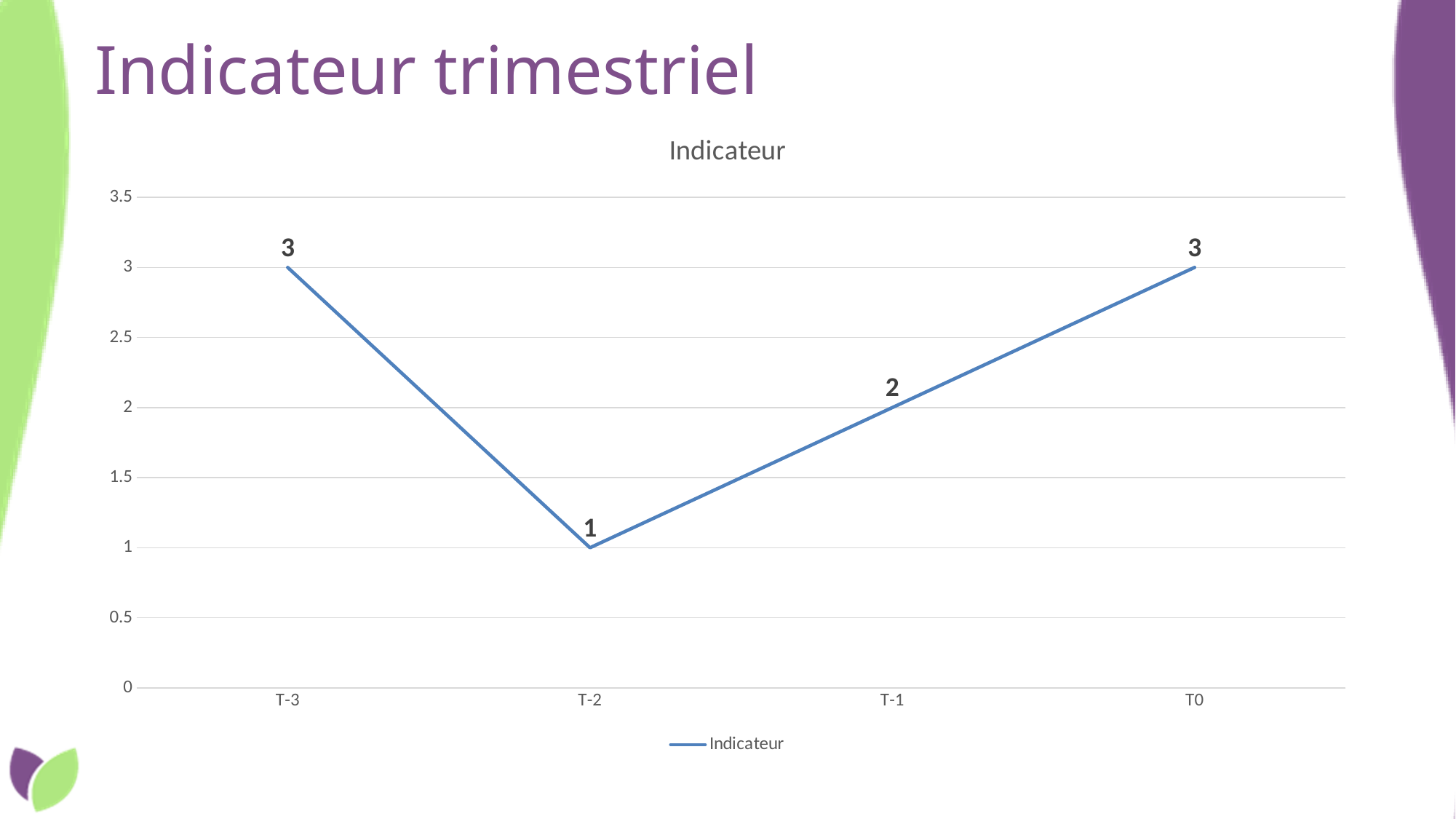
Which is larger, the Indicateur value at T-1 or at T-2? T-1 What is the value of Indicateur at T-2? 1 What is the value of Indicateur at T0? 3 Do the Indicateur values rise or fall from T-2 to T0? rise What is the title of the chart? Indicateur Is the value for T-1 greater or less than 1.5? greater At which point on the x axis is the Indicateur value lowest? T-2 How many points are plotted on the x axis? 4 What is the difference between the Indicateur values at T-3 and T-2? 2 How many series does the legend list? 1 What kind of chart is shown on the slide? line chart What is the value of Indicateur at T-1? 2